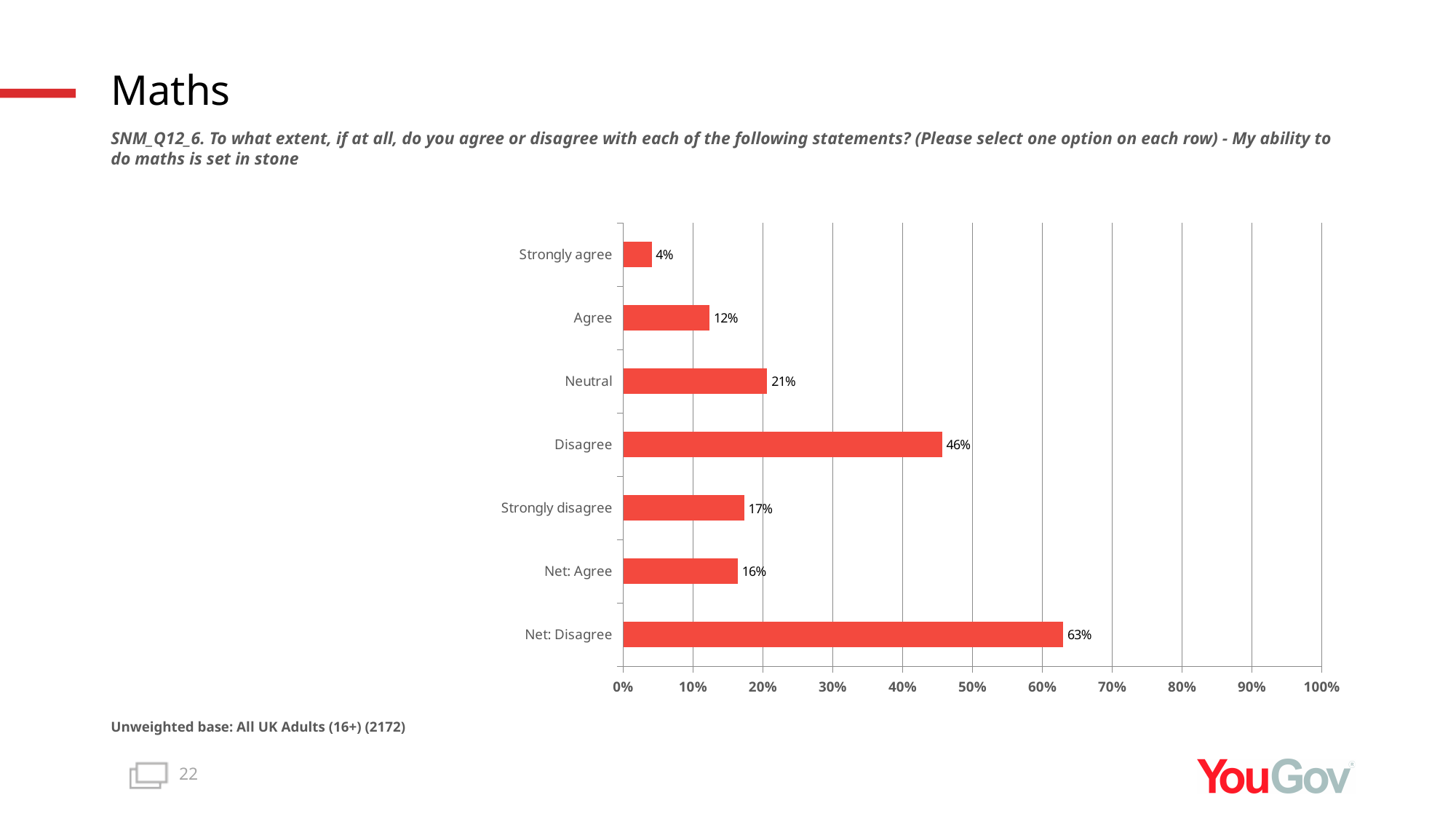
What is the value shown for 'Strongly agree'? 4% What is the difference between 'Disagree' and 'Strongly disagree'? 29% Which is larger, 'Agree' or 'Strongly disagree'? Strongly disagree Is the value for 'Disagree' greater or less than 40%? greater What kind of chart is shown on the slide? Bar chart What percentage of respondents selected 'Disagree'? 46% What percentage of respondents selected 'Neutral'? 21% Which category has the highest value? Net: Disagree What is the value shown for 'Net: Disagree'? 63% What is the difference between 'Net: Disagree' and 'Net: Agree'? 47% How many categories are shown on the chart? 7 Which category has the lowest value? Strongly agree